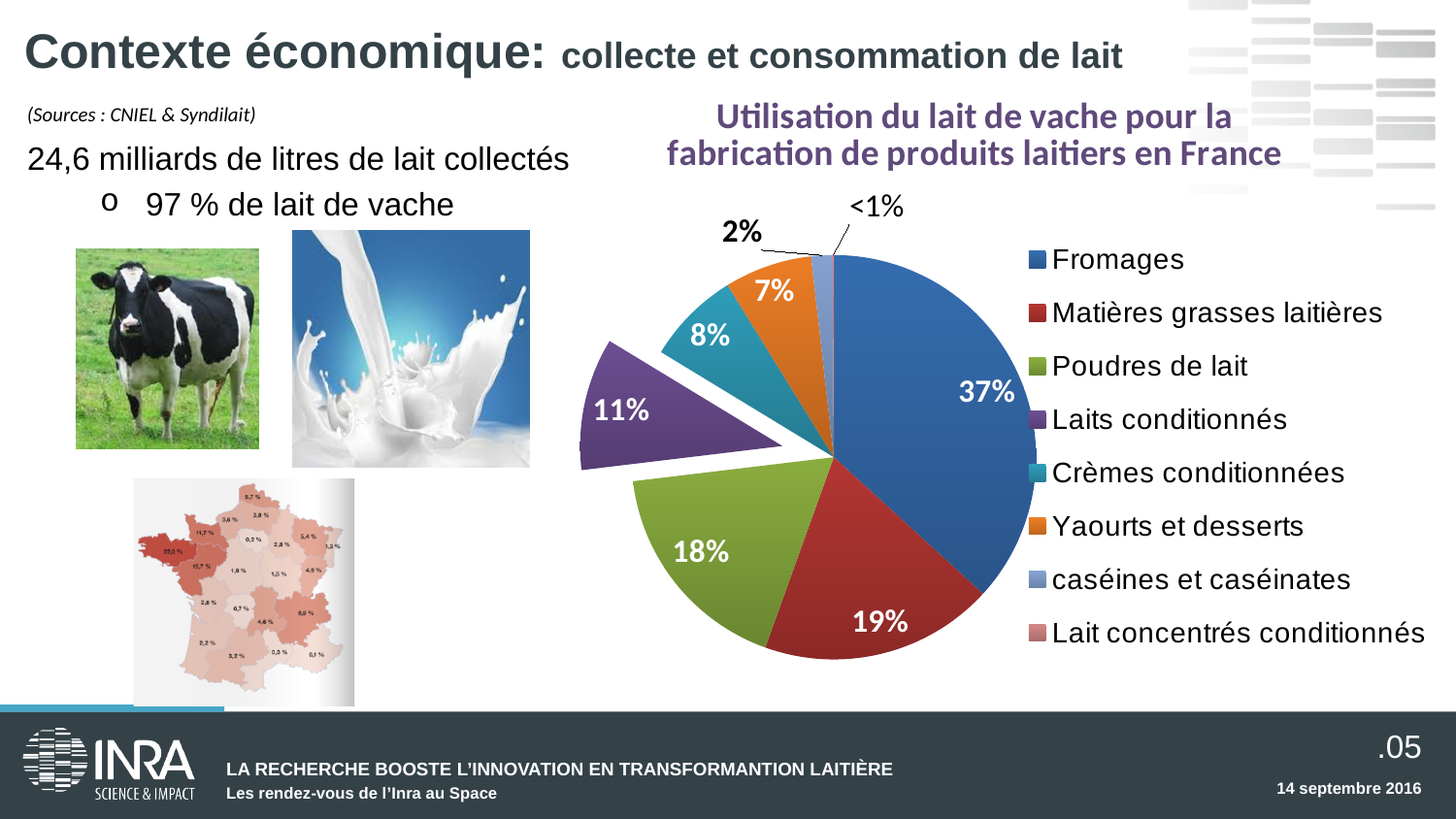
What is the difference in share between Fromages and Matières grasses laitières? 18 percentage points Which has a larger share, Crèmes conditionnées or Yaourts et desserts? Crèmes conditionnées What share of cow's milk is used for Matières grasses laitières? 19% What share of cow's milk is used for Poudres de lait? 18% What share of cow's milk is used for Yaourts et desserts? 7% What share of cow's milk is used for Fromages? 37% What share of cow's milk is used for Laits conditionnés? 11% What is the title of the pie chart? Utilisation du lait de vache pour la fabrication de produits laitiers en France How many categories does the legend of the pie chart list? 8 Which category has the largest share of the pie? Fromages Which category has the smallest share of the pie? Lait concentrés conditionnés What kind of chart is shown on the slide? Pie chart